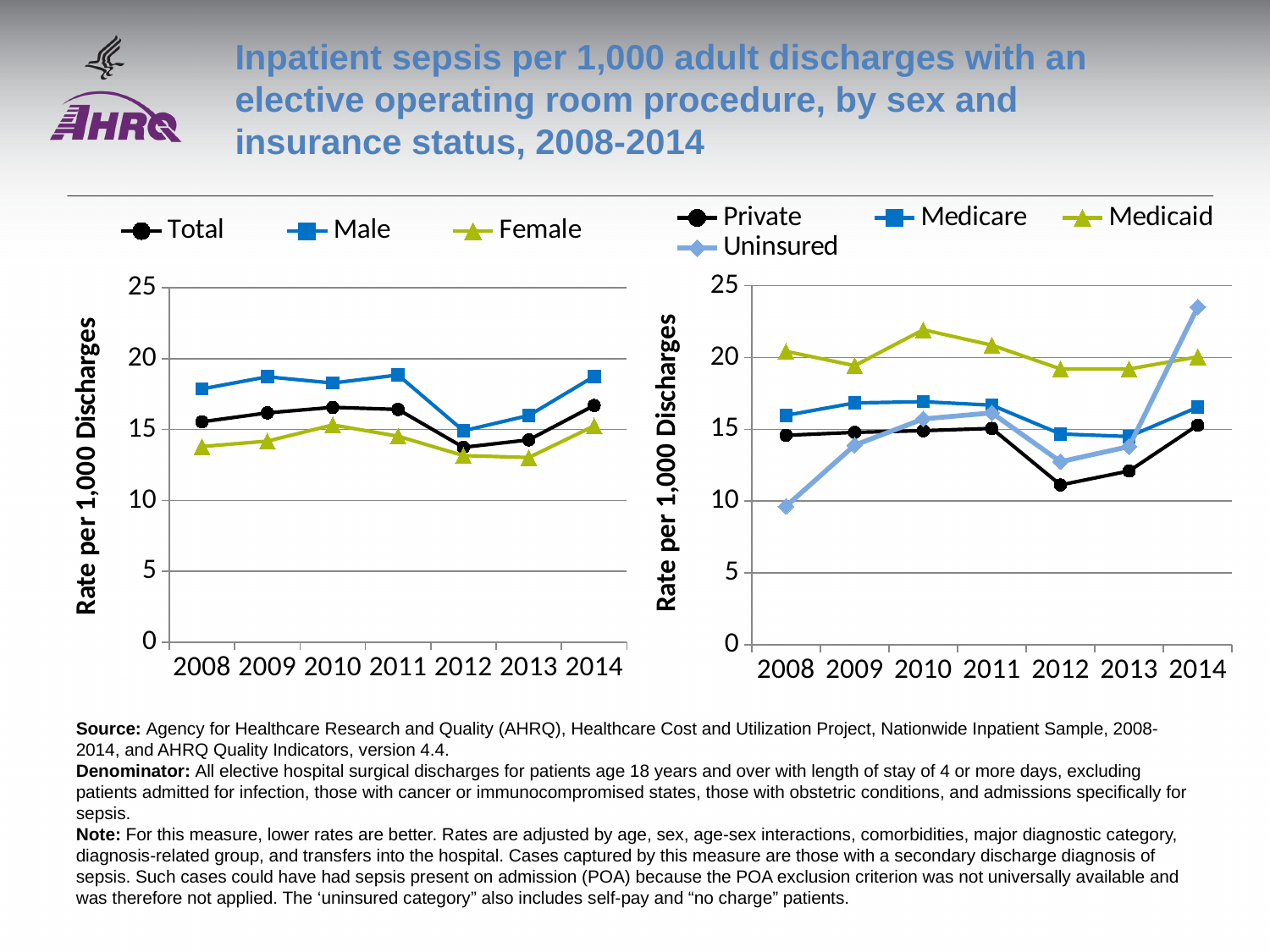
How many years are plotted on the x axis of the right chart (by insurance status)? 7 In the right chart (by insurance status), is the Medicaid rate in 2010 greater or less than 20? greater In the left chart (by sex), which series has the highest rate in 2011? Male In the right chart (by insurance status), which series has the highest rate in 2014? Uninsured In the left chart (by sex), is the Male rate in 2011 greater or less than 15? greater What kind of chart is the left chart (Total, Male, Female)? line chart In the left chart (by sex), which series has the lowest rate in 2013? Female In the right chart (by insurance status), which is larger in 2012: the Private rate or the Medicare rate? Medicare How many series does the legend of the left chart (by sex) list? 3 How many series does the legend of the right chart (by insurance status) list? 4 In the left chart (by sex), is the Female rate in 2013 greater or less than 15? less In the right chart (by insurance status), which series has the lowest rate in 2008? Uninsured